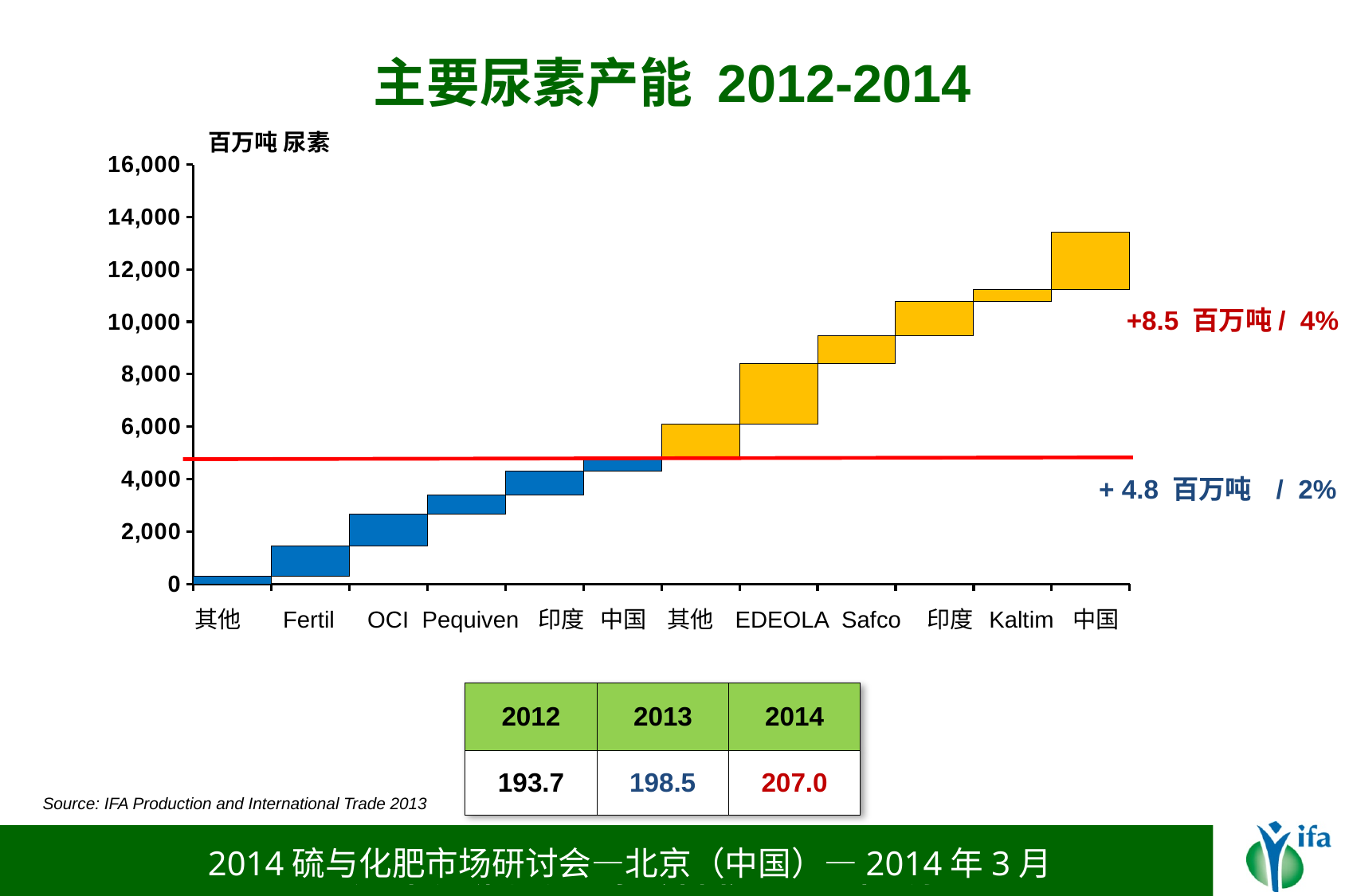
What increase is annotated in red next to the orange bars? +8.5 百万吨 / 4% What is the title of the chart? 主要尿素产能 2012-2014 Is the red horizontal line greater or less than 6,000? less Is the top of the Safco bar greater or less than 10,000? less Do the cumulative bar heights rise or fall from left to right along the x axis? rise What is the highest tick value shown on the y axis? 16,000 Is the top of the Fertil bar greater or less than 2,000? less What kind of chart is shown on the slide? bar chart In the table below the chart, what is the value for 2014? 207.0 How many categories are labelled along the x axis of the chart? 12